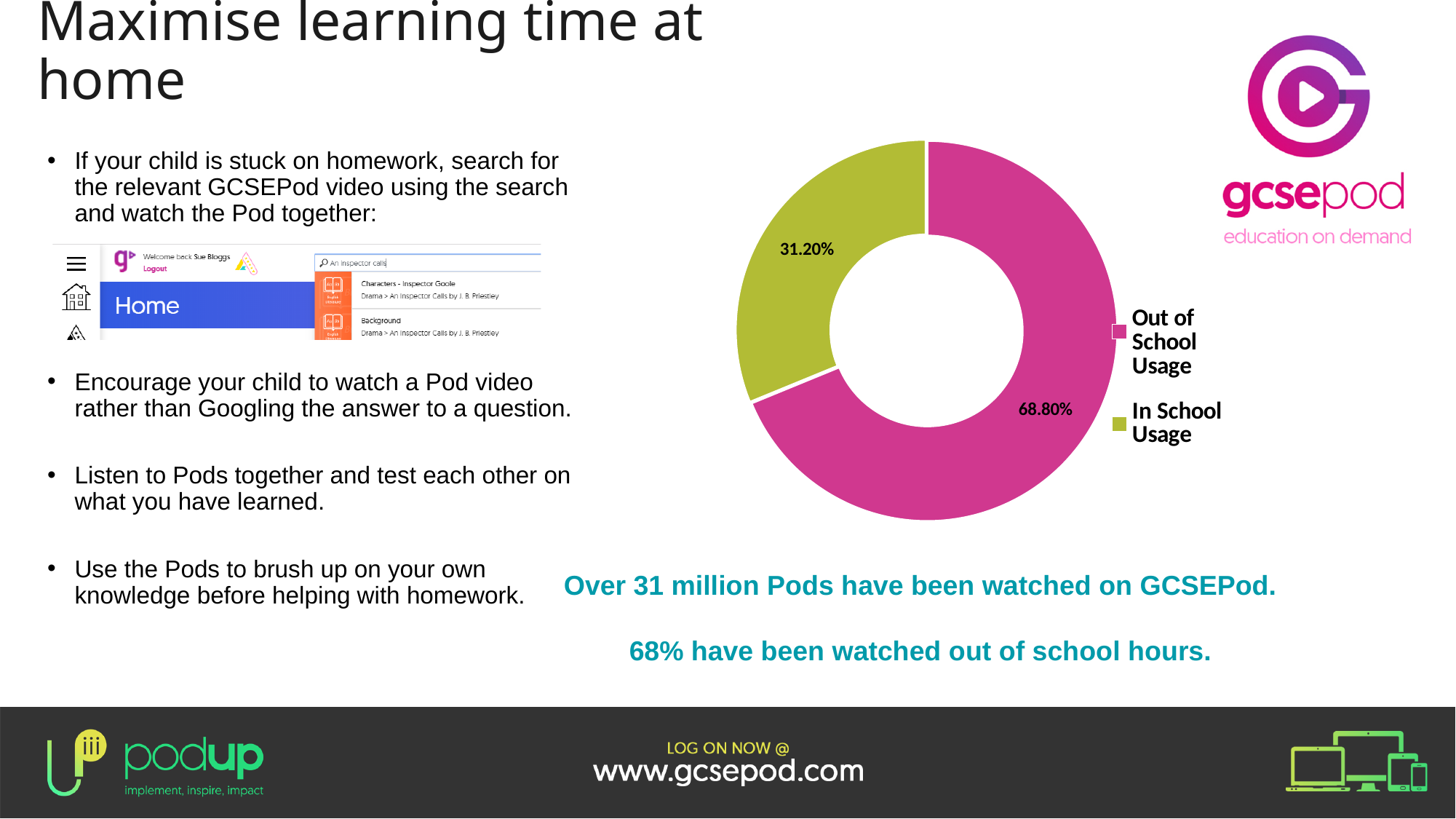
How many categories does the chart show? 2 What is the difference in percentage points between Out of School Usage and In School Usage? 37.60% What colour represents In School Usage in the chart? Green What kind of chart is shown on the slide? Pie chart (doughnut) What percentage of the chart is In School Usage? 31.20% Which is larger, Out of School Usage or In School Usage? Out of School Usage What percentage of the chart is Out of School Usage? 68.80% Which category has the largest share of the chart? Out of School Usage What colour represents Out of School Usage in the chart? Pink Which category has the smallest share of the chart? In School Usage